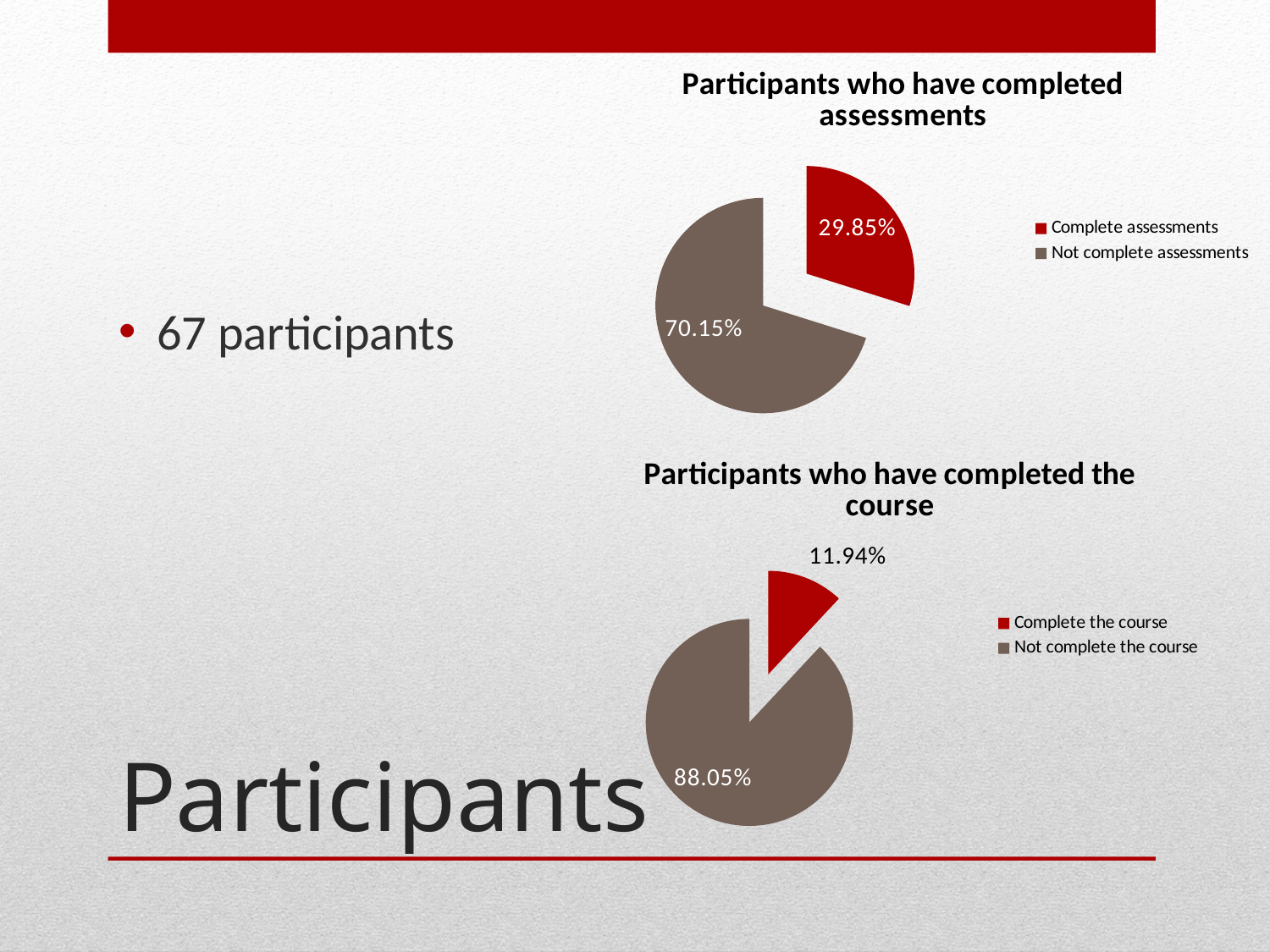
What type of chart is the 'Participants who have completed the course' chart? Pie chart In the 'Participants who have completed the course' chart, what colour is the 'Complete the course' slice? Red In the 'Participants who have completed the course' chart, what share of participants did not complete the course? 88.05% In the 'Participants who have completed assessments' chart, what share of participants completed assessments? 29.85% In the 'Participants who have completed the course' chart, what is the difference between the 'Not complete the course' and 'Complete the course' shares? 76.11% In the 'Participants who have completed assessments' chart, which slice is the largest? Not complete assessments In the 'Participants who have completed the course' chart, which slice is the smallest? Complete the course Which is larger: the 'Complete assessments' share in the top chart or the 'Complete the course' share in the bottom chart? Complete assessments In the 'Participants who have completed assessments' chart, what is the difference between the 'Not complete assessments' and 'Complete assessments' shares? 40.30% In the 'Participants who have completed the course' chart, what share of participants completed the course? 11.94% How many slices does the 'Participants who have completed assessments' chart have? 2 In the 'Participants who have completed assessments' chart, what share of participants did not complete assessments? 70.15%